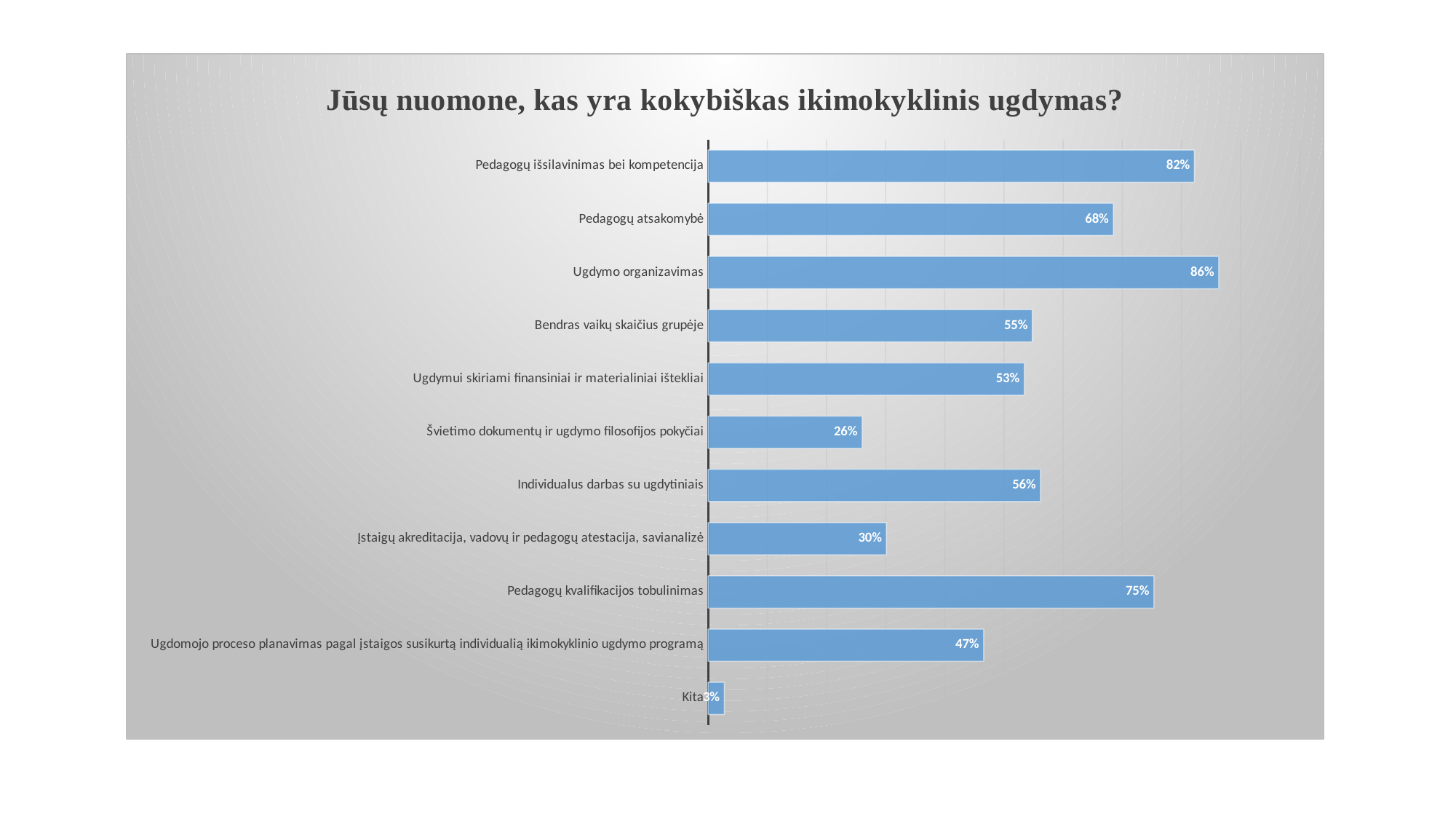
What is the value for "Pedagogų atsakomybė"? 68% What is the value for "Ugdymo organizavimas"? 86% What is the value for "Švietimo dokumentų ir ugdymo filosofijos pokyčiai"? 26% What is the title of the chart? Jūsų nuomone, kas yra kokybiškas ikimokyklinis ugdymas? How many categories are shown in the chart? 11 What is the value for "Ugdomojo proceso planavimas pagal įstaigos susikurtą individualią ikimokyklinio ugdymo programą"? 47% Which category has the highest value? Ugdymo organizavimas What is the difference between "Pedagogų išsilavinimas bei kompetencija" and "Pedagogų kvalifikacijos tobulinimas"? 7% Which is larger: "Individualus darbas su ugdytiniais" or "Įstaigų akreditacija, vadovų ir pedagogų atestacija, savianalizė"? Individualus darbas su ugdytiniais What is the difference between "Bendras vaikų skaičius grupėje" and "Ugdymui skiriami finansiniai ir materialiniai ištekliai"? 2% Which category has the lowest value? Kita What kind of chart is shown on the slide? Bar chart